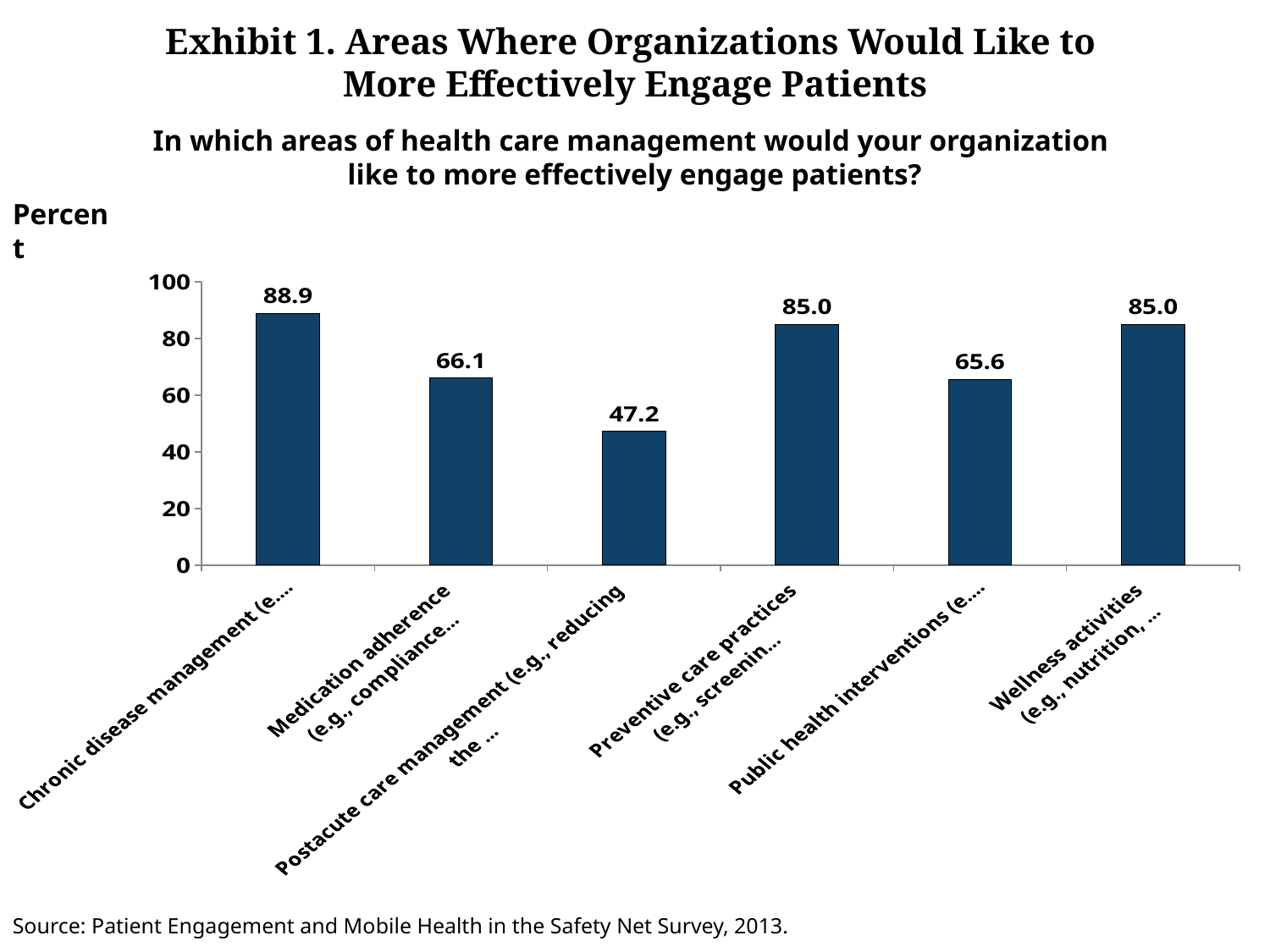
How many areas are shown in the chart? 6 What is the value for Public health interventions? 65.6 Which area has the highest value? Chronic disease management Is the value for Wellness activities greater or less than 80? greater Which area has the lowest value? Postacute care management What is the difference between the values for Chronic disease management and Postacute care management? 41.7 What is the label on the vertical axis of the chart? Percent What is the value for Postacute care management? 47.2 What kind of chart is shown on the slide? bar chart What is the value for Chronic disease management? 88.9 What is the value for Medication adherence? 66.1 Which is larger, the value for Preventive care practices or the value for Medication adherence? Preventive care practices